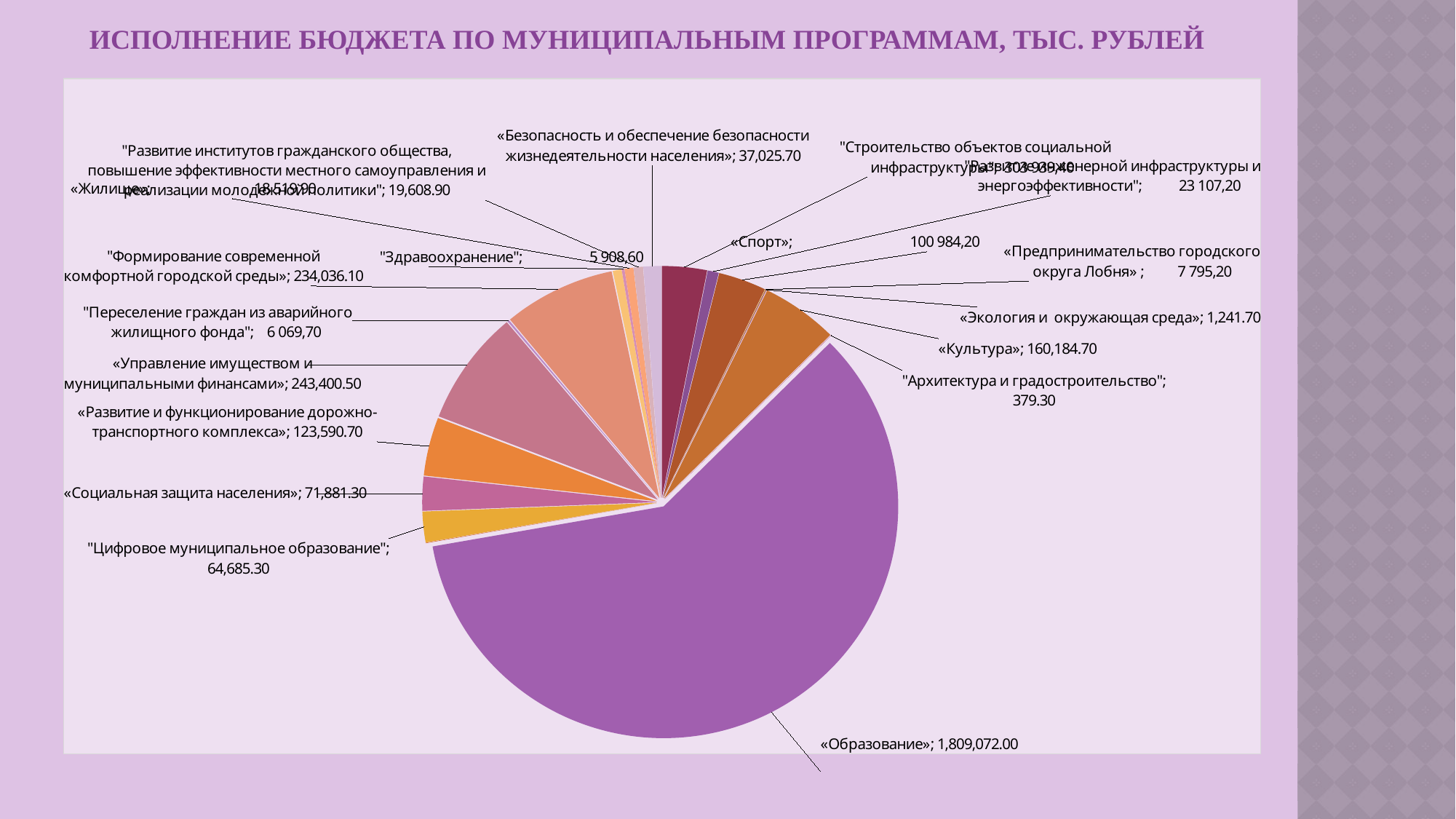
Which program has the smallest value in the chart? "Архитектура и градостроительство" What kind of chart is shown on the slide? pie chart What is the value for «Спорт»? 100 984,20 What is the title of the chart on the slide? ИСПОЛНЕНИЕ БЮДЖЕТА ПО МУНИЦИПАЛЬНЫМ ПРОГРАММАМ, ТЫС. РУБЛЕЙ What is the value for «Культура»? 160,184.70 Which is larger: «Управление имуществом и муниципальными финансами» or «Формирование современной комфортной городской среды»? «Управление имуществом и муниципальными финансами» Which program has the largest slice of the pie? «Образование» What is the value for «Экология и окружающая среда»? 1,241.70 What is the value for «Образование»? 1,809,072.00 What is the value for "Цифровое муниципальное образование"? 64,685.30 What is the difference between the values for «Культура» and «Спорт»? 59,200.50 Which is larger: «Социальная защита населения» or "Цифровое муниципальное образование"? «Социальная защита населения»